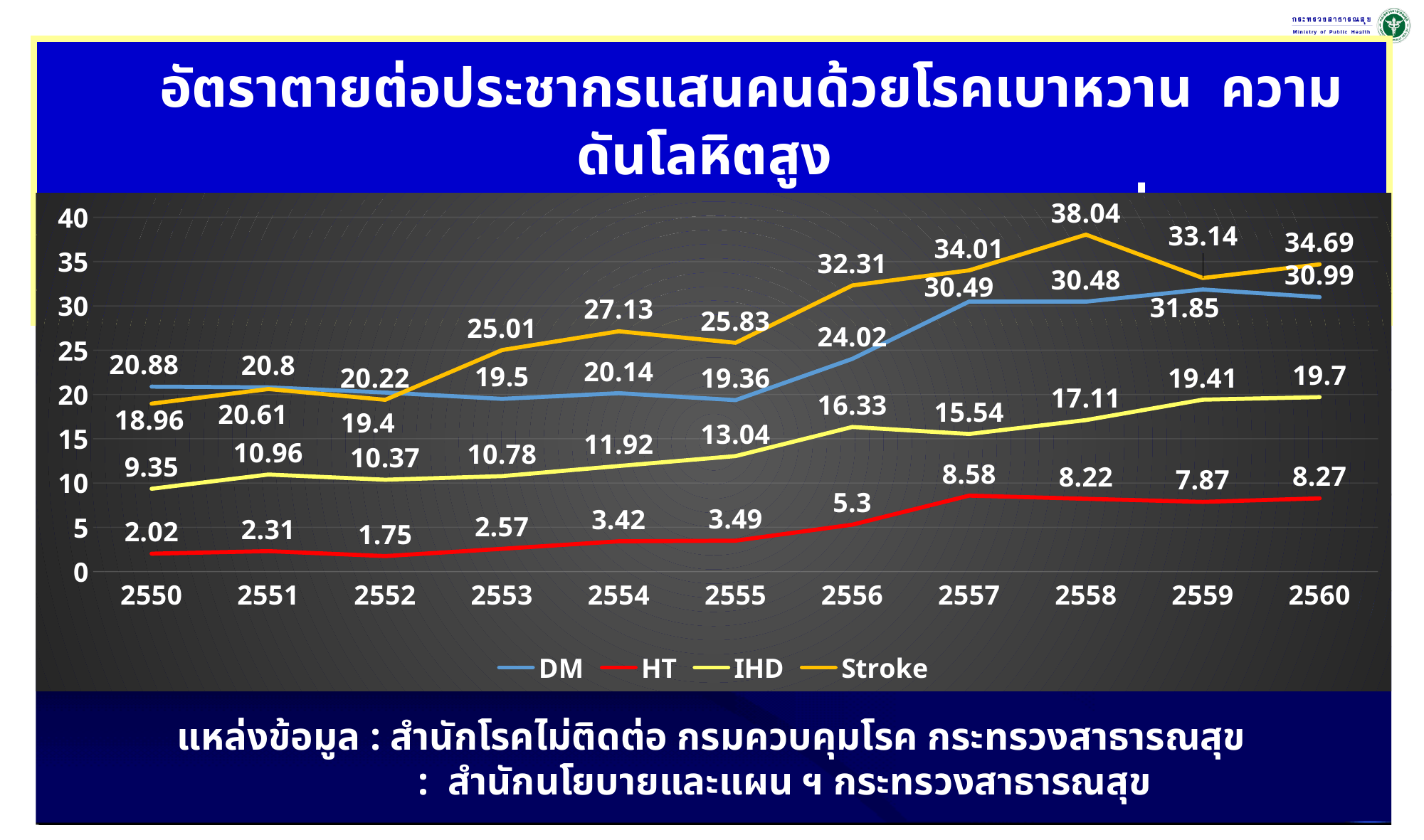
What is the difference between the IHD value in 2560 and in 2550? 10.35 What colour is the HT line in the legend? red In 2553, which is larger, the DM value or the Stroke value? Stroke What kind of chart is shown on the slide? line chart In which year is the Stroke value highest? 2558 Does the HT line generally rise or fall from 2550 to 2560? rise How many series does the legend list? 4 What is the value for Stroke in 2558? 38.04 In which year is the HT value lowest? 2552 What is the value for HT in 2552? 1.75 What is the value for DM in 2557? 30.49 How many years are shown along the x axis? 11